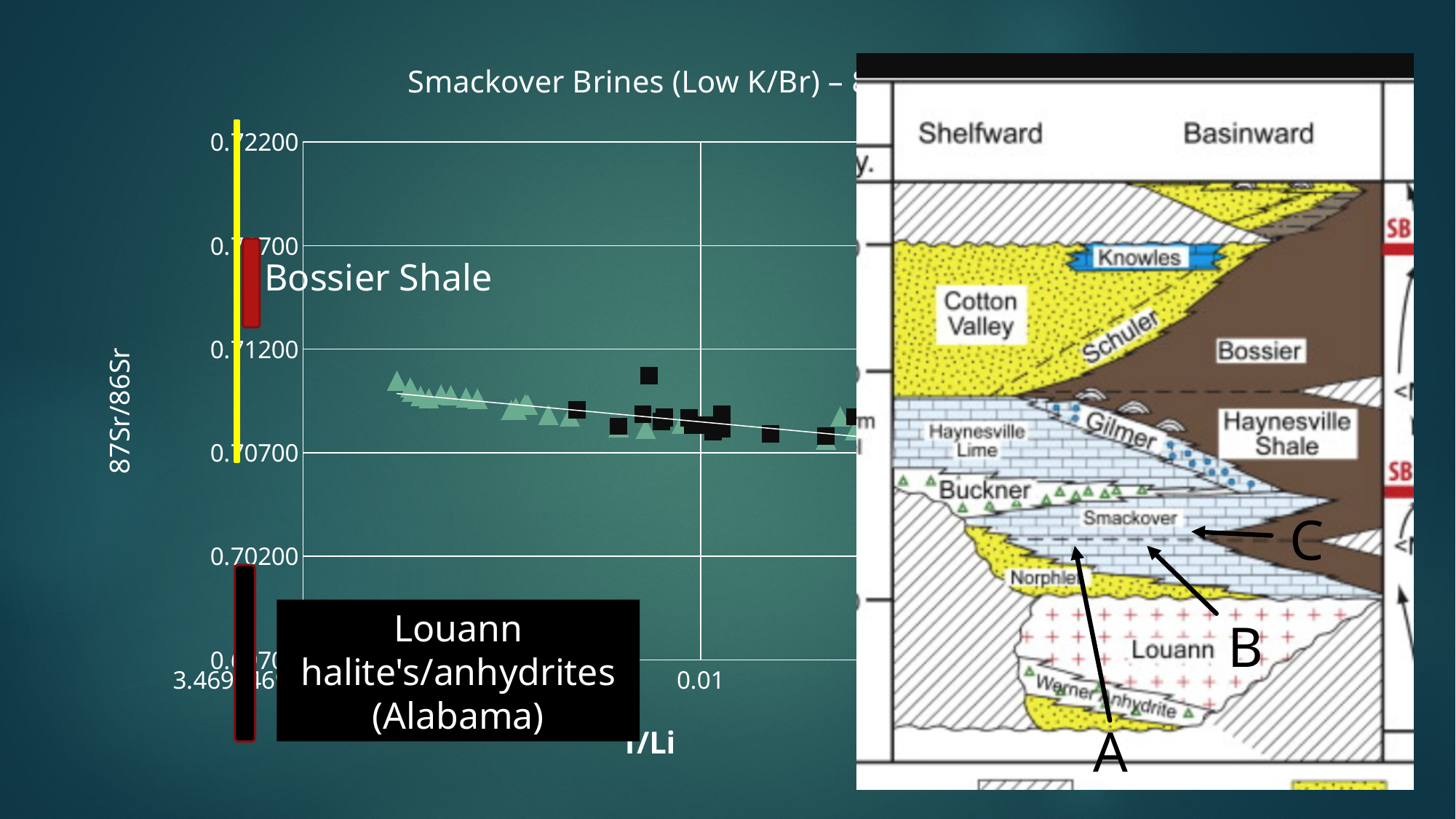
Are the black square points plotted at values greater or less than 0.70700? greater Are the green triangle points plotted at values greater or less than 0.71200? less Do the plotted 87Sr/86Sr values rise or fall as the x-axis value increases? fall How many distinct marker series (marker types) are plotted on the scatter chart? 2 What is the label on the y axis of the scatter chart? 87Sr/86Sr Are the green triangle points plotted at values greater or less than 0.70200? greater What is the highest tick value shown on the y axis of the scatter chart? 0.72200 What kind of chart is shown on the left of the slide? scatter chart